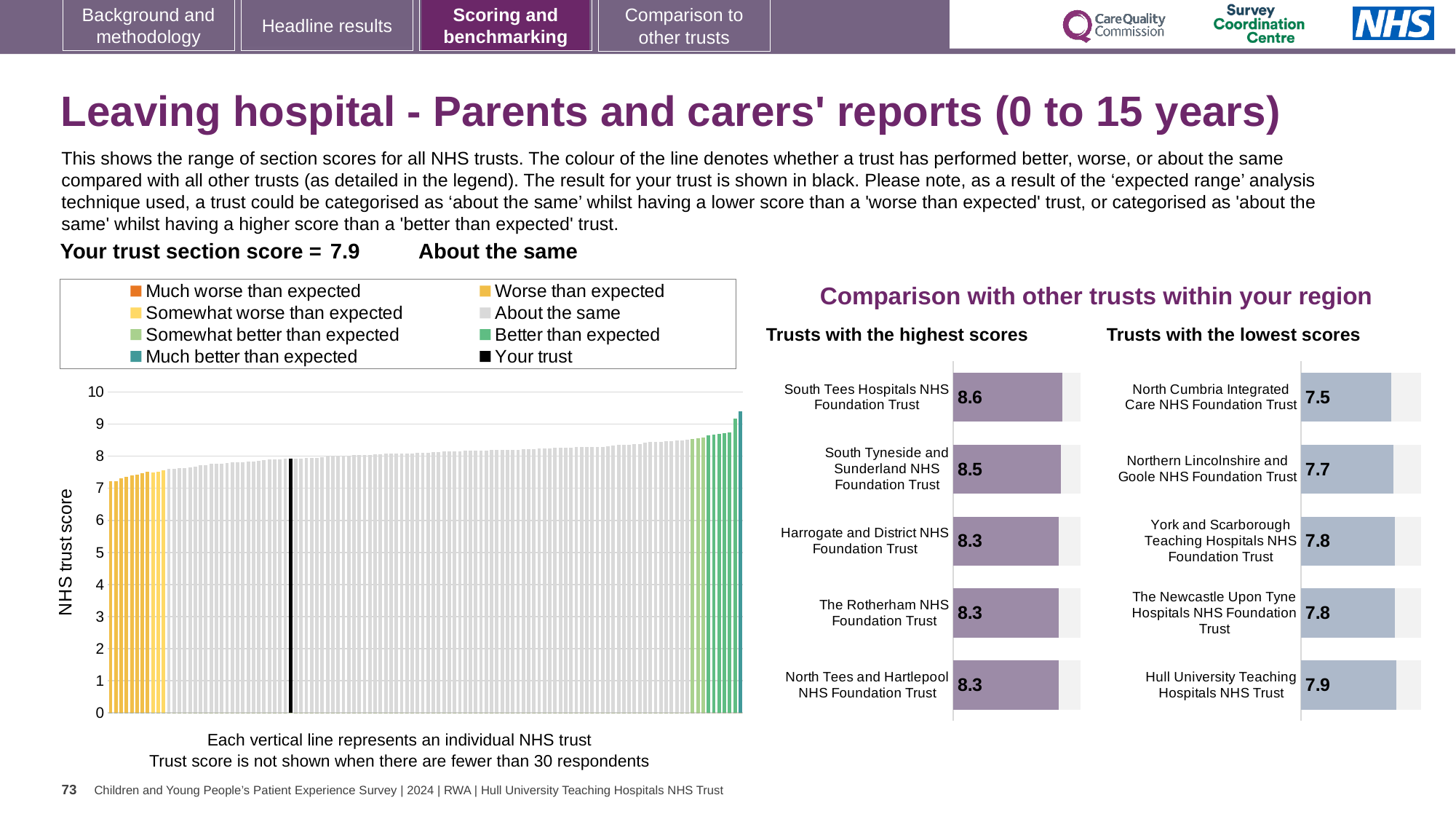
Which has the higher score: Harrogate and District NHS Foundation Trust in the 'highest scores' chart or Northern Lincolnshire and Goole NHS Foundation Trust in the 'lowest scores' chart? Harrogate and District NHS Foundation Trust In the 'Trusts with the lowest scores' chart, what is the score for North Cumbria Integrated Care NHS Foundation Trust? 7.5 In the 'Trusts with the lowest scores' chart, what is the difference between the scores of Hull University Teaching Hospitals NHS Trust and North Cumbria Integrated Care NHS Foundation Trust? 0.4 In the 'Trusts with the highest scores' chart, which trust has the highest score? South Tees Hospitals NHS Foundation Trust In the 'Trusts with the lowest scores' chart, which trust has the lowest score? North Cumbria Integrated Care NHS Foundation Trust In the 'Trusts with the highest scores' chart, what is the score for South Tees Hospitals NHS Foundation Trust? 8.6 How many entries does the legend of the left-hand 'NHS trust score' chart list? 8 In the left-hand 'NHS trust score' chart, what is the section score for your trust (shown in black)? 7.9 In the 'Trusts with the highest scores' chart, what is the difference between the scores of South Tees Hospitals NHS Foundation Trust and South Tyneside and Sunderland NHS Foundation Trust? 0.1 In the left-hand 'NHS trust score' chart, do the trust scores rise or fall from left to right? Rise How many trusts are shown in the 'Trusts with the highest scores' chart? 5 What kind of chart is the large 'NHS trust score' chart on the left of the slide? Bar chart